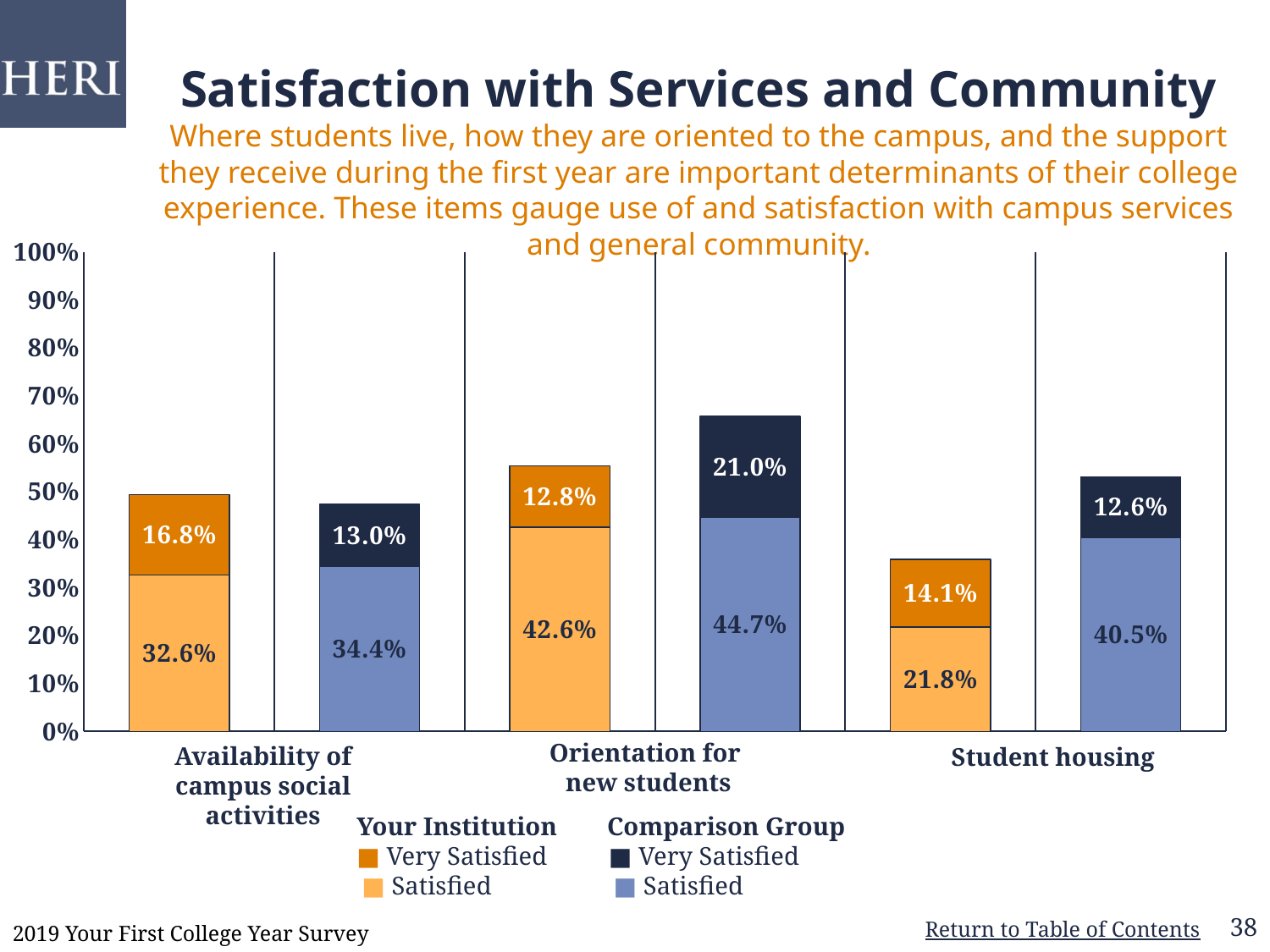
Which group has the larger Satisfied percentage for student housing, Your Institution or the Comparison Group? Comparison Group Across the three items, which Comparison Group stacked bar is the tallest? Orientation for new students What is the difference between the Comparison Group's and Your Institution's Very Satisfied percentages for orientation for new students? 8.2% How many entries does the chart legend list? 4 What type of chart is shown on the slide? Stacked bar chart What percentage of Your Institution students are Very Satisfied with the availability of campus social activities? 16.8% What percentage of Your Institution students are Satisfied with student housing? 21.8% What is the combined Satisfied and Very Satisfied percentage for Your Institution on student housing? 35.9% What is the combined Satisfied and Very Satisfied percentage for the Comparison Group on orientation for new students? 65.7% What percentage of the Comparison Group is Satisfied with orientation for new students? 44.7% How many items (categories) are shown on the x axis of the chart? 3 Across the three items, which Your Institution stacked bar is the shortest? Student housing